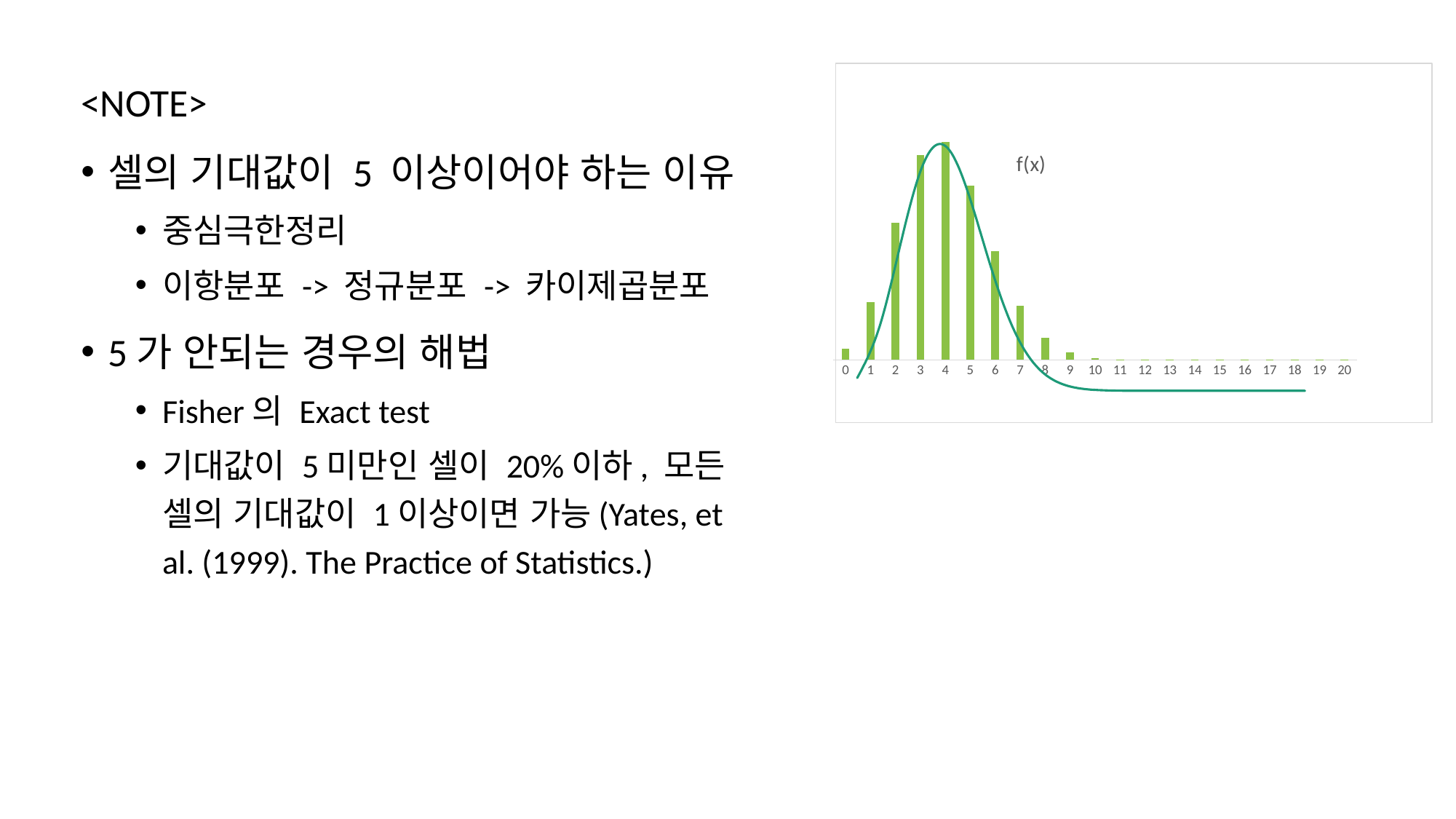
Which bar is taller, the one at 1 or the one at 5? 5 Which bar is taller, the one at 8 or the one at 2? 2 What is the first category label on the x axis? 0 Do the bar heights rise or fall as x goes from 4 to 9? fall How many categories are labelled on the x axis? 21 Which x-axis category has the tallest bar? 4 Is the bar at 3 taller or shorter than the bar at 7? taller Do the bar heights rise or fall as x goes from 0 to 4? rise What label is shown next to the curve drawn over the bars? f(x) What kind of chart is shown on the slide? bar chart